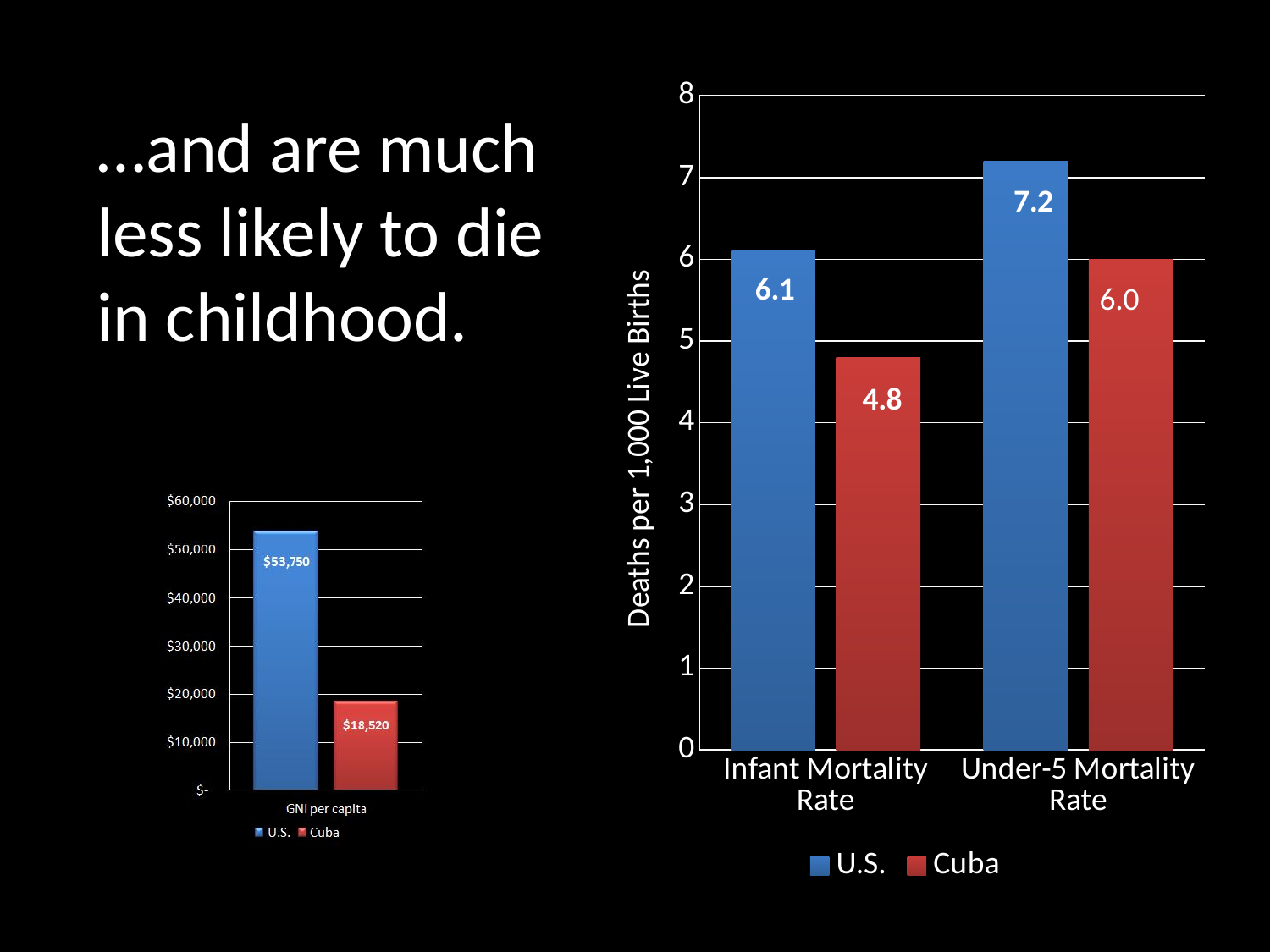
In the mortality chart on the right, what is Cuba's value for Infant Mortality Rate? 4.8 In the GNI per capita chart on the left, what is the value for Cuba? $18,520 In the mortality chart on the right, what is the y-axis label? Deaths per 1,000 Live Births In the mortality chart on the right, which is larger for Under-5 Mortality Rate, the U.S. or Cuba? U.S. In the mortality chart on the right, which bar is the highest? U.S., Under-5 Mortality Rate In the GNI per capita chart on the left, what is the difference between the U.S. and Cuba values? $35,230 In the mortality chart on the right, what is the difference between the U.S. and Cuba values for Infant Mortality Rate? 1.3 In the mortality chart on the right, what is the U.S. value for Infant Mortality Rate? 6.1 In the mortality chart on the right, what is Cuba's value for Under-5 Mortality Rate? 6.0 What kind of chart is the GNI per capita chart on the left? Bar chart In the GNI per capita chart on the left, what is the value for the U.S.? $53,750 In the mortality chart on the right, how many series does the legend list? 2